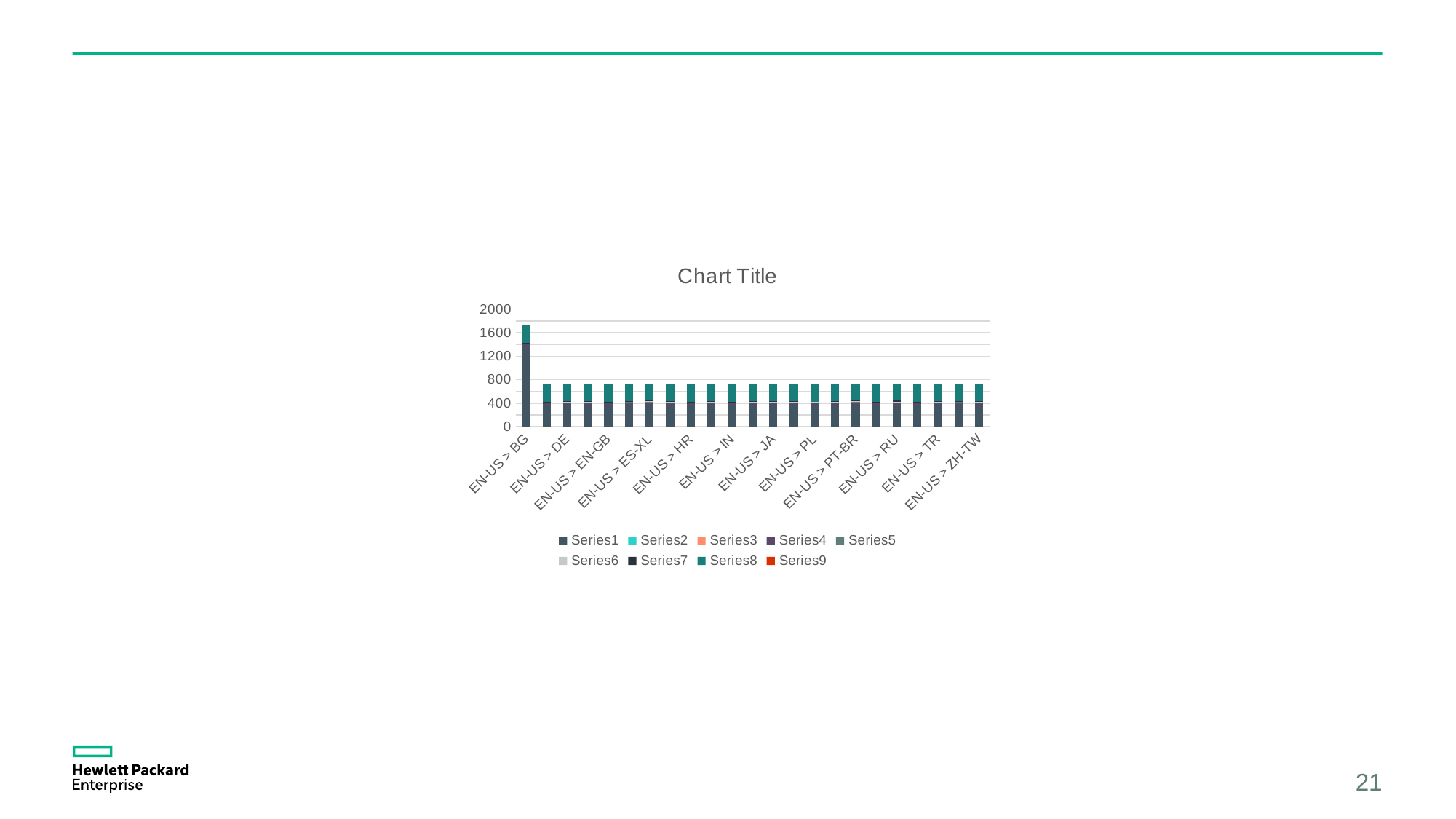
Is the total stacked value for EN-US > PT-BR greater or less than 1200? less Is the total stacked value for EN-US > BG greater or less than 2000? less Which has the larger total stacked value, EN-US > BG or EN-US > ZH-TW? EN-US > BG Is the total stacked value for EN-US > DE greater or less than 800? less What is the highest value shown on the vertical axis? 2000 Which category has the tallest stacked bar? EN-US > BG What kind of chart is shown on the slide? Stacked bar chart How many series does the legend list? 9 What is the title of the chart? Chart Title